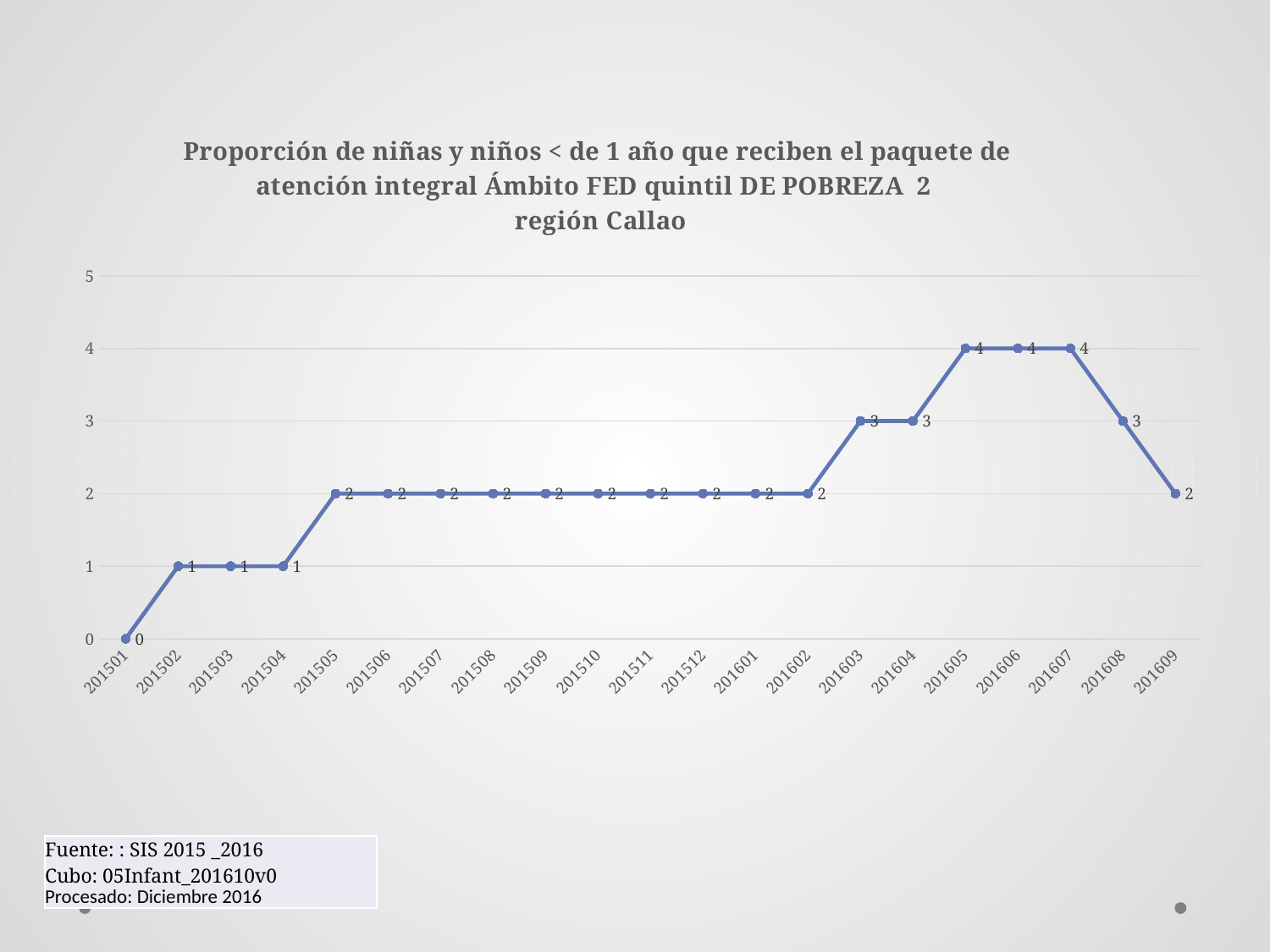
What kind of chart is shown on the slide? line chart Does the value rise or fall from 201607 to 201609? fall What is the highest value plotted on the chart? 4 What is the value for 201603? 3 What is the difference between the values for 201607 and 201608? 1 What is the value for 201605? 4 What is the value for 201609? 2 Which is larger, the value for 201504 or the value for 201604? 201604 Which period has the lowest value? 201501 What is the value for 201501? 0 Which region is named in the chart title? Callao How many data points are plotted on the chart? 21